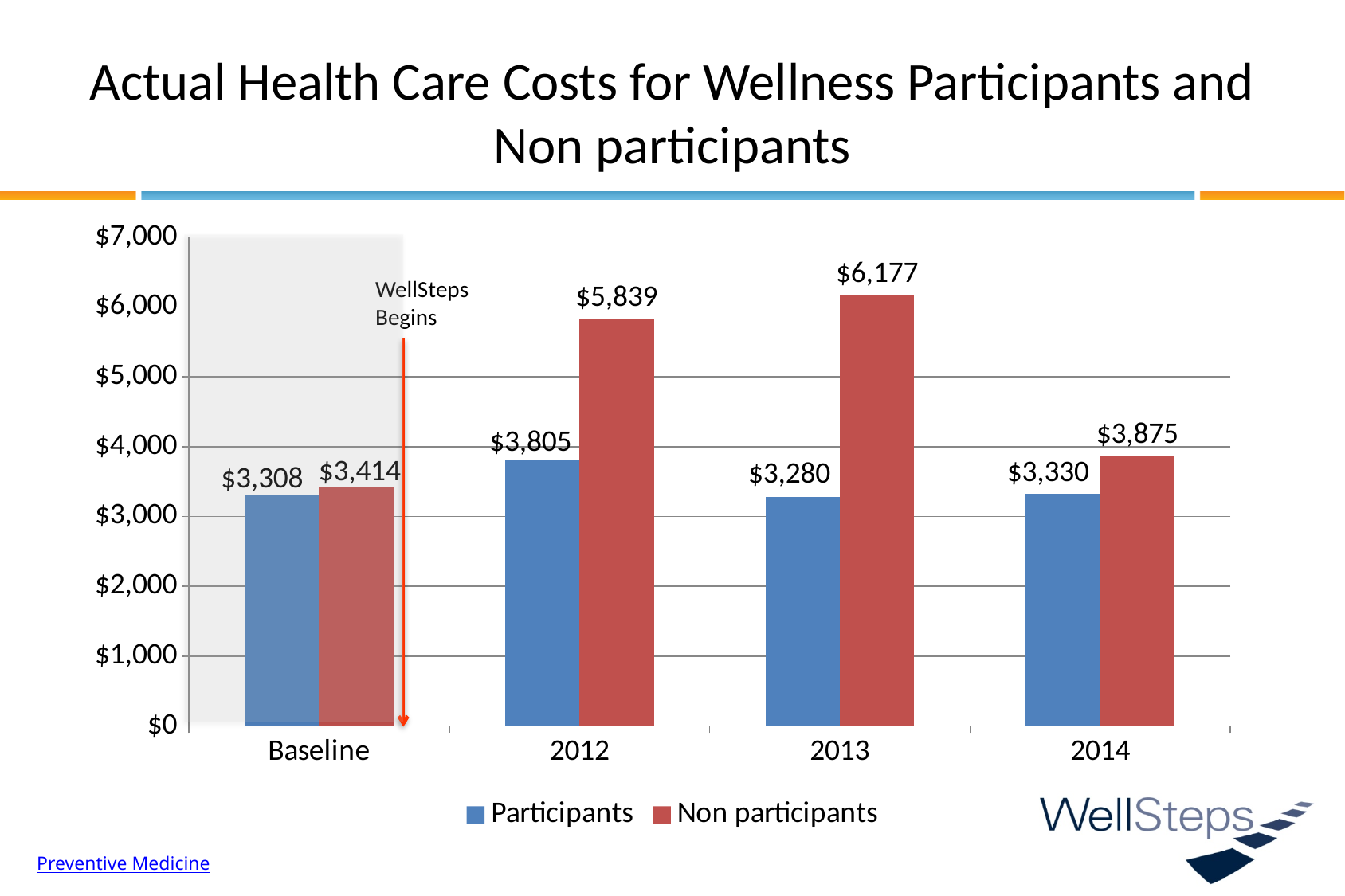
Is the Non participants cost in 2012 greater or less than $5,000? greater What is the health care cost for Non participants at Baseline? $3,414 What is the health care cost for Participants in 2012? $3,805 What is the health care cost for Participants in 2014? $3,330 Which is larger in 2014, the Participants cost or the Non participants cost? Non participants How many periods are shown on the x axis? 4 In which year is the Non participants cost highest? 2013 In which period is the Participants cost lowest? 2013 What is the difference between Non participants and Participants costs in 2013? $2,897 What kind of chart is shown on the slide? Bar chart What is the health care cost for Non participants in 2013? $6,177 How many series does the legend list? 2